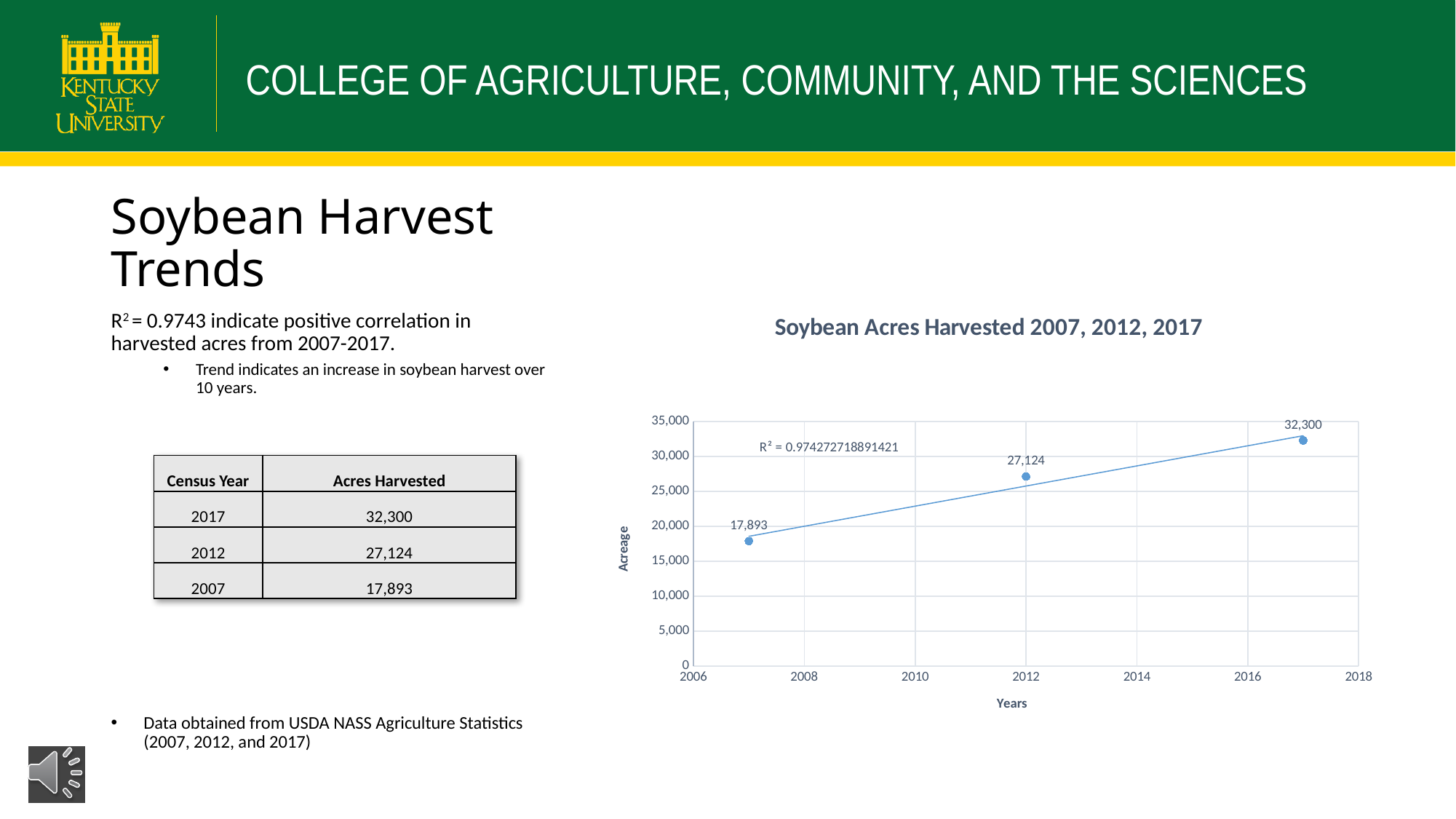
Do the acreage values rise or fall from 2007 to 2017? rise What is the acreage value plotted for 2012? 27,124 What kind of chart is shown on the slide? scatter chart How many data points are plotted on the chart? 3 What is the difference in acreage between 2017 and 2007? 14,407 Which year has the larger acreage, 2012 or 2017? 2017 Which year has the highest acreage? 2017 What is the acreage value plotted for 2017? 32,300 What is the title of the chart? Soybean Acres Harvested 2007, 2012, 2017 Which year has the lowest acreage? 2007 What is the acreage value plotted for 2007? 17,893 What is the difference in acreage between 2012 and 2007? 9,231